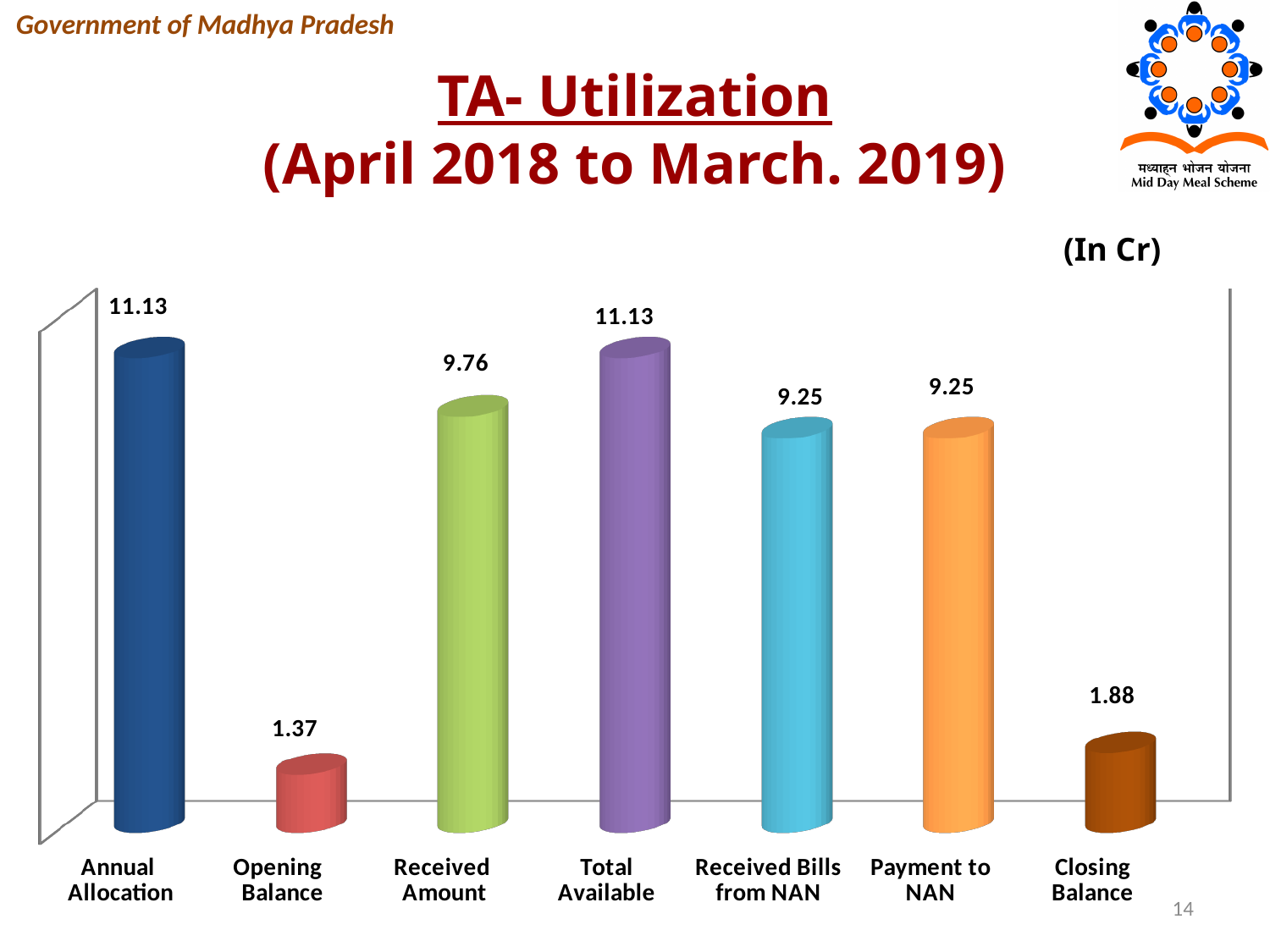
Which is larger, Received Amount or Payment to NAN? Received Amount What is the value for Opening Balance? 1.37 What is the difference between Total Available and Received Bills from NAN? 1.88 What unit is indicated for the values in the chart? In Cr What kind of chart is shown on the slide? Bar chart How many categories are shown in the chart? 7 Which category has the lowest value? Opening Balance What is the value for Closing Balance? 1.88 What is the value for Payment to NAN? 9.25 What is the difference between Received Amount and Opening Balance? 8.39 What is the value for Annual Allocation? 11.13 What is the value for Received Amount? 9.76